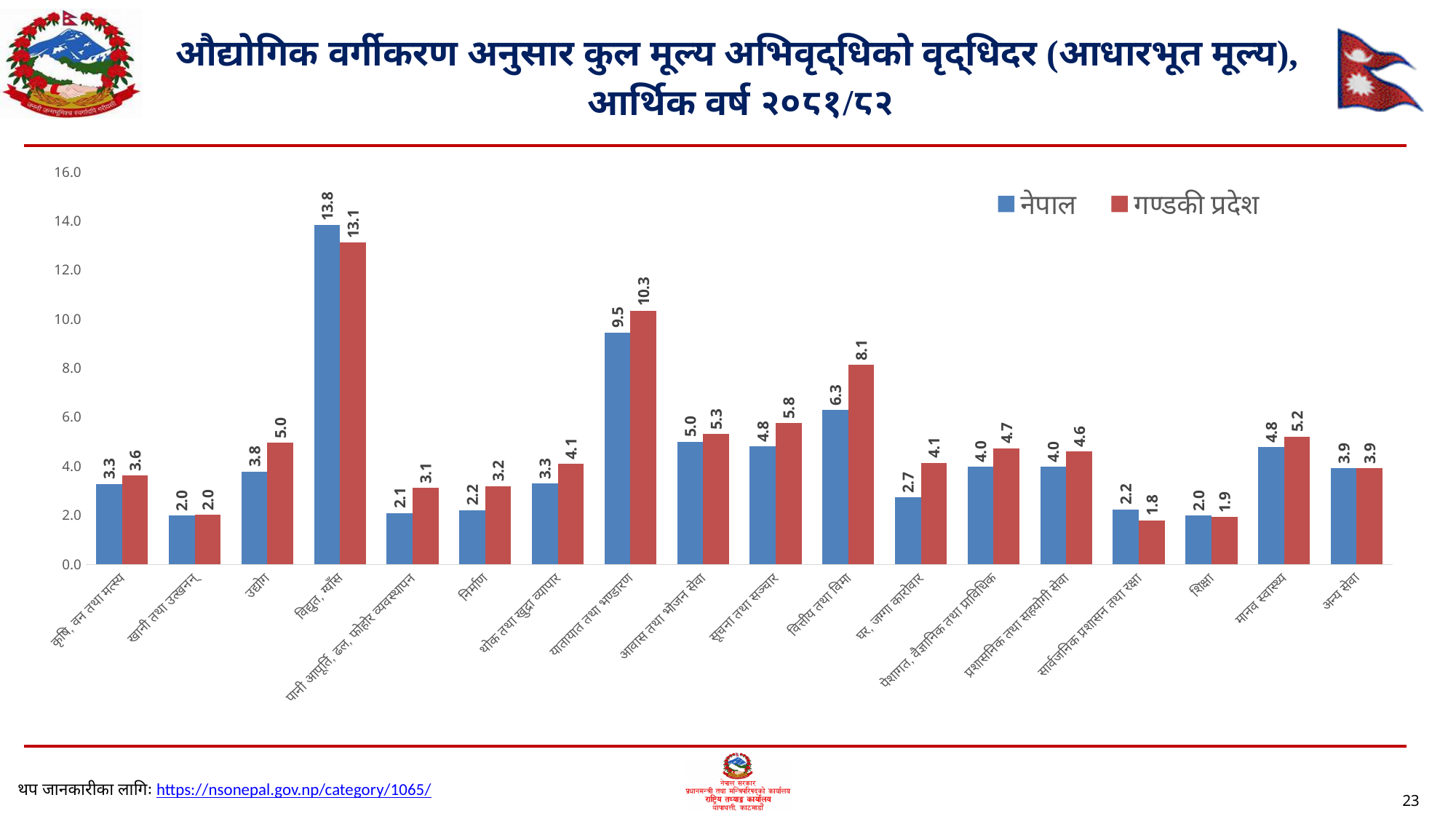
What is the difference between the गण्डकी प्रदेश and नेपाल values in the वित्तीय तथा बिमा category? 1.8 In the विद्युत, ग्याँस category, which series has the larger value, नेपाल or गण्डकी प्रदेश? नेपाल What kind of chart is shown on the slide? Bar chart Which category has the highest value for नेपाल? विद्युत, ग्याँस How many categories are shown on the x axis of the chart? 18 What is the value for नेपाल in the विद्युत, ग्याँस category? 13.8 In the घर, जग्गा कारोबार category, which series has the larger value, नेपाल or गण्डकी प्रदेश? गण्डकी प्रदेश What is the value for गण्डकी प्रदेश in the यातायात तथा भण्डारण category? 10.3 Which category has the lowest value for गण्डकी प्रदेश? सार्वजनिक प्रशासन तथा रक्षा What is the value for गण्डकी प्रदेश in the वित्तीय तथा बिमा category? 8.1 How many series does the legend list? 2 Which colour represents गण्डकी प्रदेश in the chart? Red